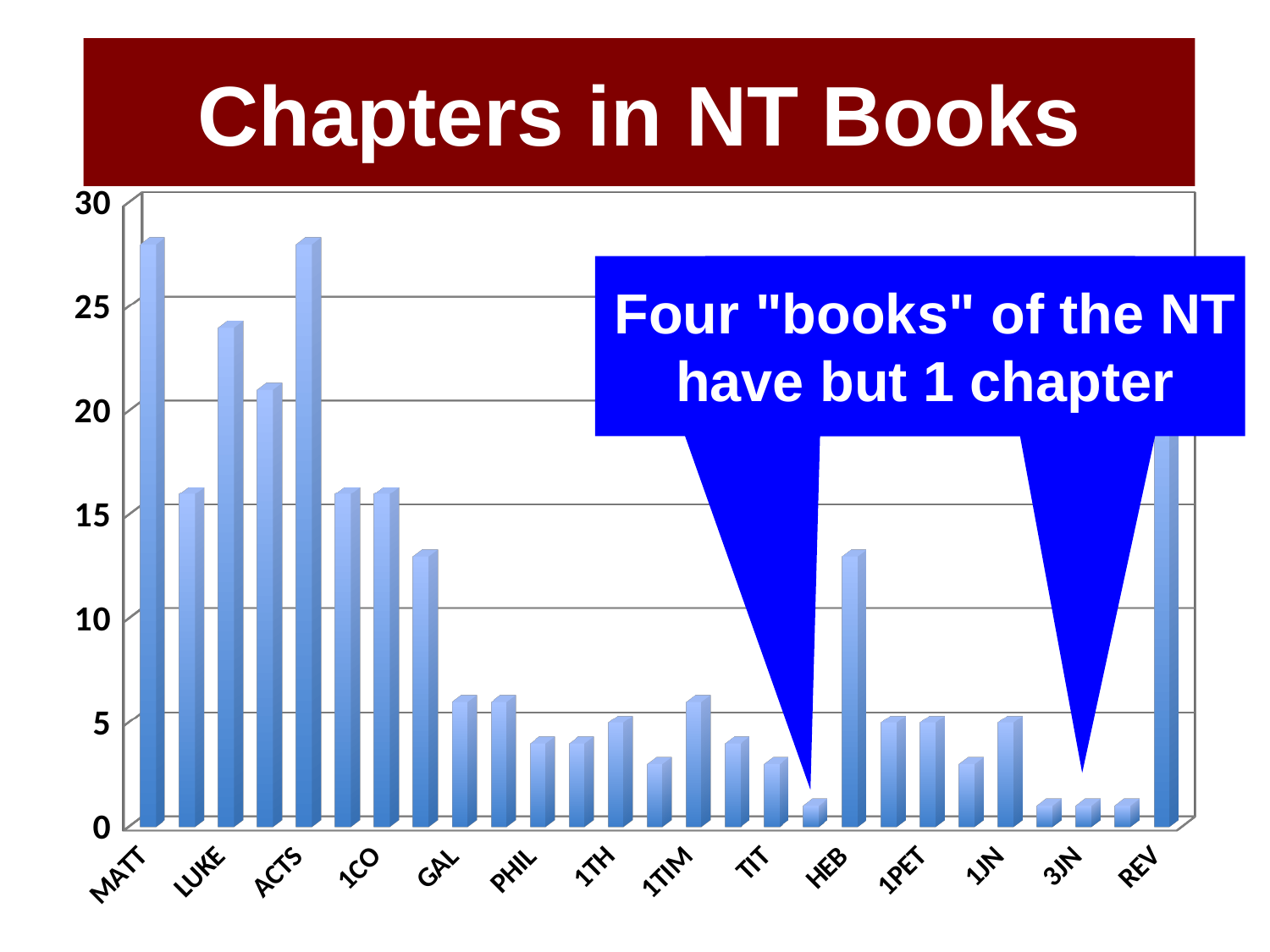
Is the value for LUKE greater or less than 20? greater Is the value for HEB greater or less than 10? greater Is the value for 3JN greater or less than 5? less Which has the larger value, HEB or GAL? HEB What does the blue callout on the chart say? Four "books" of the NT have but 1 chapter Which has the larger value, MATT or LUKE? MATT What is the title of the chart? Chapters in NT Books How many category labels are shown on the x axis? 14 What kind of chart is shown on the slide? bar chart